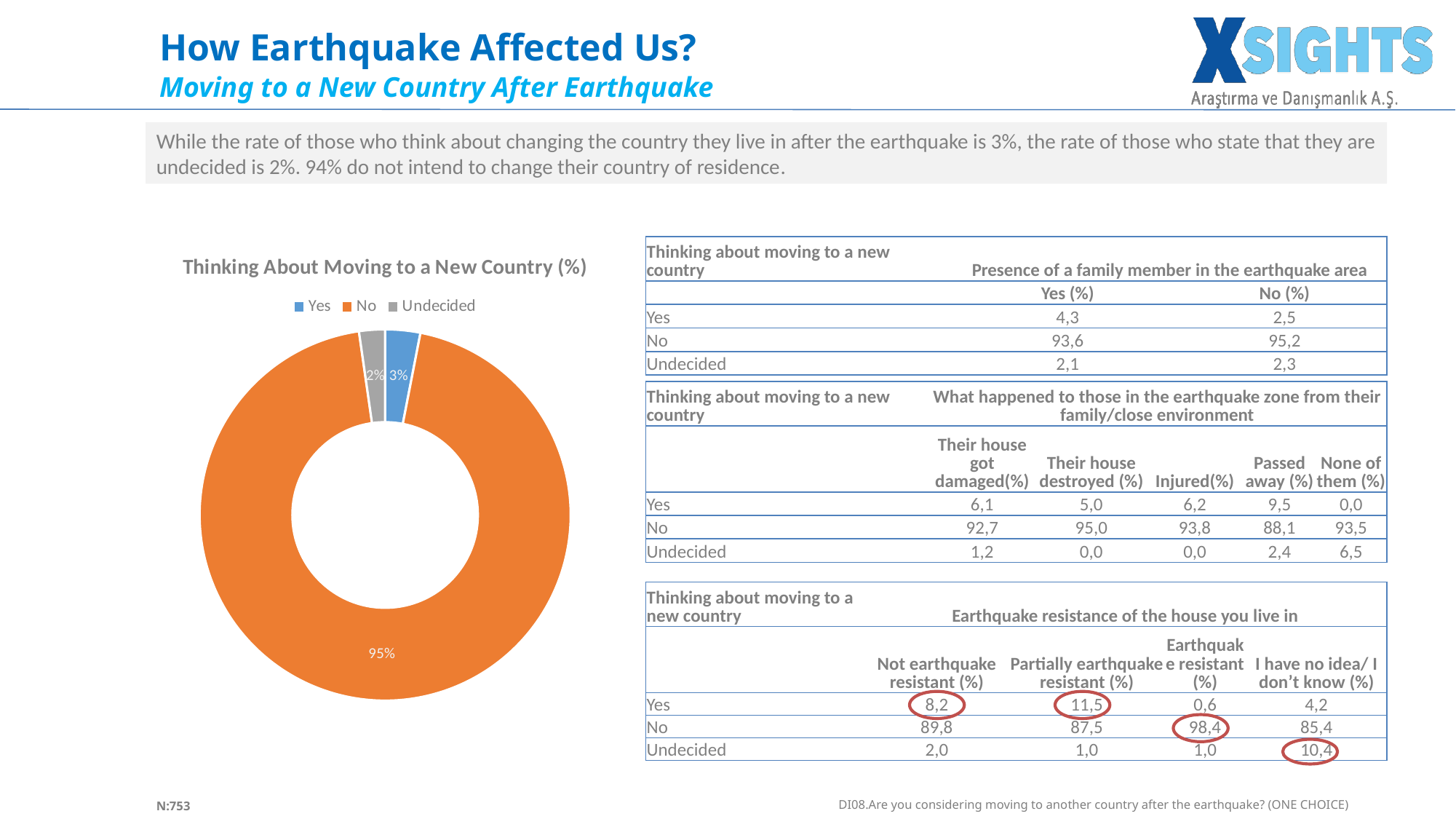
What percentage of respondents are 'Undecided' according to the chart? 2% Which category has the smallest share in the chart? Undecided What percentage of respondents answered 'Yes' in the chart? 3% What type of chart is shown on the slide? Donut chart How many slices does the donut chart have? 3 What percentage of respondents answered 'No' in the chart? 95% What is the difference between the 'No' share and the 'Yes' share in the chart? 92% Which category has the largest share in the chart? No Which is larger in the chart, the 'Yes' share or the 'Undecided' share? Yes How many categories does the chart's legend list? 3 What is the title of the chart on the slide? Thinking About Moving to a New Country (%) Which colour represents the 'No' category in the chart? Orange